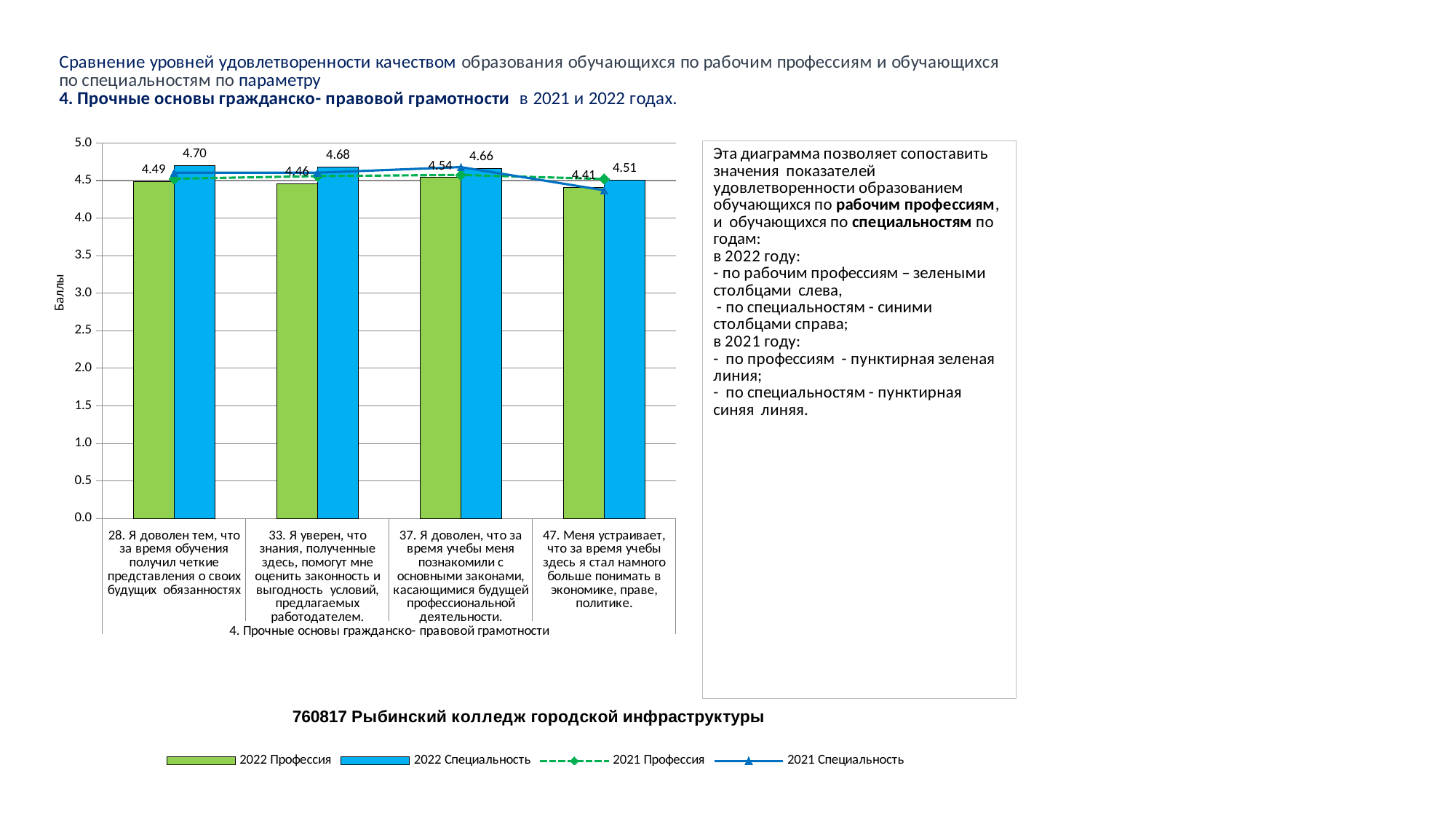
Which category has the highest 2022 Специальность bar? 28. Я доволен тем, что за время обучения получил четкие представления о своих будущих обязанностях What is the difference between the 2022 Специальность and 2022 Профессия values for category 28? 0.21 What is the label of the y axis of the chart? Баллы How many series does the chart legend list? 4 Is the 2022 Профессия value for category 33 greater or less than 4.0? greater Which category has the lowest 2022 Профессия bar? 47. Меня устраивает, что за время учебы здесь я стал намного больше понимать в экономике, праве, политике What is the value of the 2022 Профессия bar for category 28 ("Я доволен тем, что за время обучения получил четкие представления о своих будущих обязанностях")? 4.49 What type of chart is used to show the 2022 values? bar chart What is the value of the 2022 Профессия bar for category 47 ("Меня устраивает, что за время учебы здесь я стал намного больше понимать в экономике, праве, политике")? 4.41 How many categories are shown on the x axis of the chart? 4 For category 37, which is larger: the 2022 Профессия bar or the 2022 Специальность bar? 2022 Специальность What is the value of the 2022 Специальность bar for category 33 ("Я уверен, что знания, полученные здесь, помогут мне оценить законность и выгодность условий, предлагаемых работодателем")? 4.68